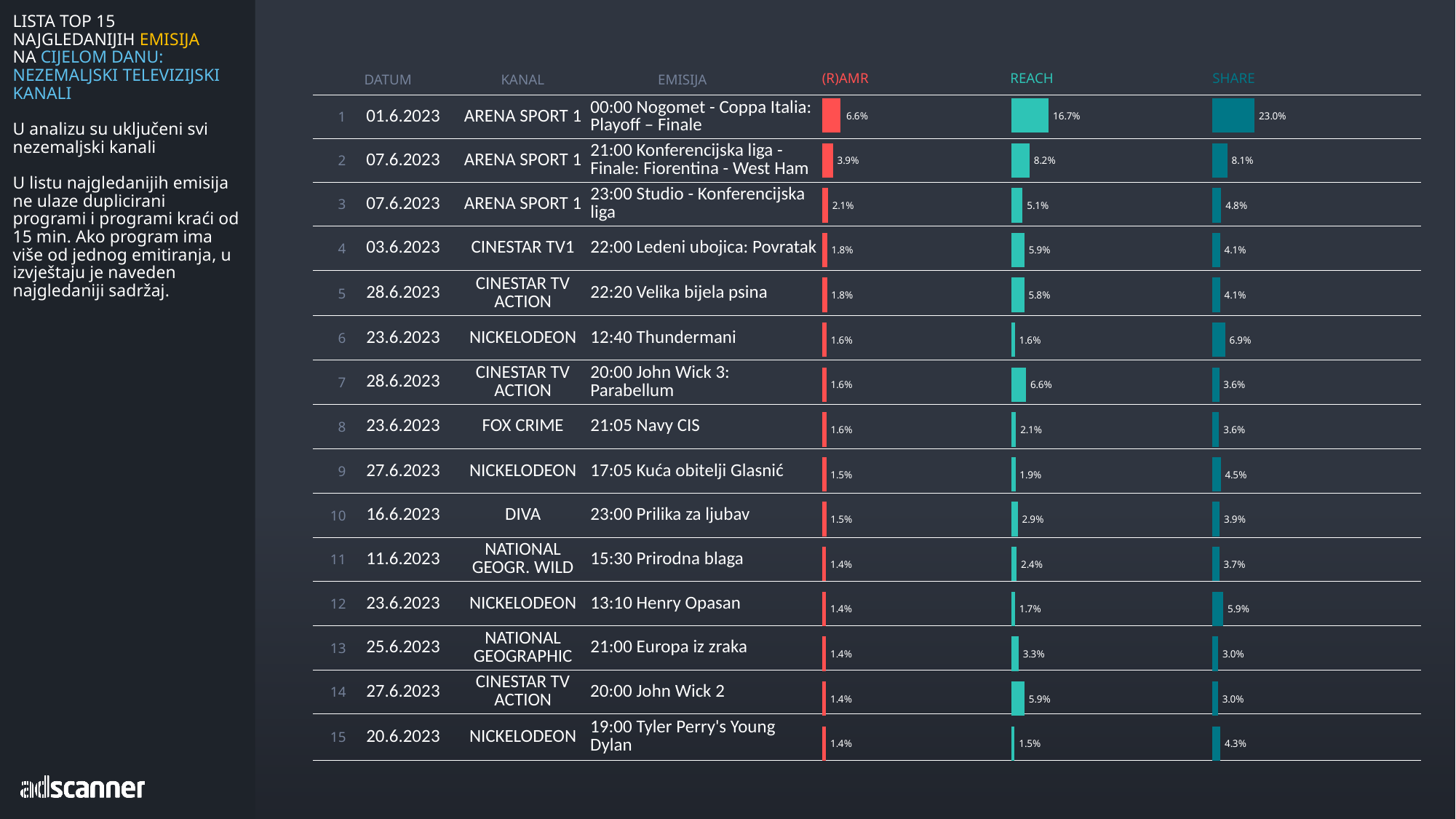
In the SHARE chart, which programme has the highest value? 00:00 Nogomet - Coppa Italia: Playoff – Finale In the (R)AMR chart, what is the difference between 21:00 Konferencijska liga - Finale: Fiorentina - West Ham and 23:00 Studio - Konferencijska liga? 1.8% In the SHARE chart, what is the difference between 00:00 Nogomet - Coppa Italia: Playoff – Finale and 21:00 Konferencijska liga - Finale: Fiorentina - West Ham? 14.9% How many programmes are listed in the (R)AMR chart? 15 What kind of chart is used for the REACH column? Bar chart In the REACH chart, what is the value for 20:00 John Wick 3: Parabellum? 6.6% In the SHARE chart, what is the value for 12:40 Thundermani? 6.9% In the REACH chart, which programme has the highest value? 00:00 Nogomet - Coppa Italia: Playoff – Finale In the REACH chart, which is larger: 22:00 Ledeni ubojica: Povratak or 21:05 Navy CIS? 22:00 Ledeni ubojica: Povratak In the REACH chart, which programme has the lowest value? 19:00 Tyler Perry's Young Dylan In the (R)AMR chart, what is the value for 00:00 Nogomet - Coppa Italia: Playoff – Finale? 6.6% Do the (R)AMR values rise or fall going down the list from rank 1 to rank 15? Fall